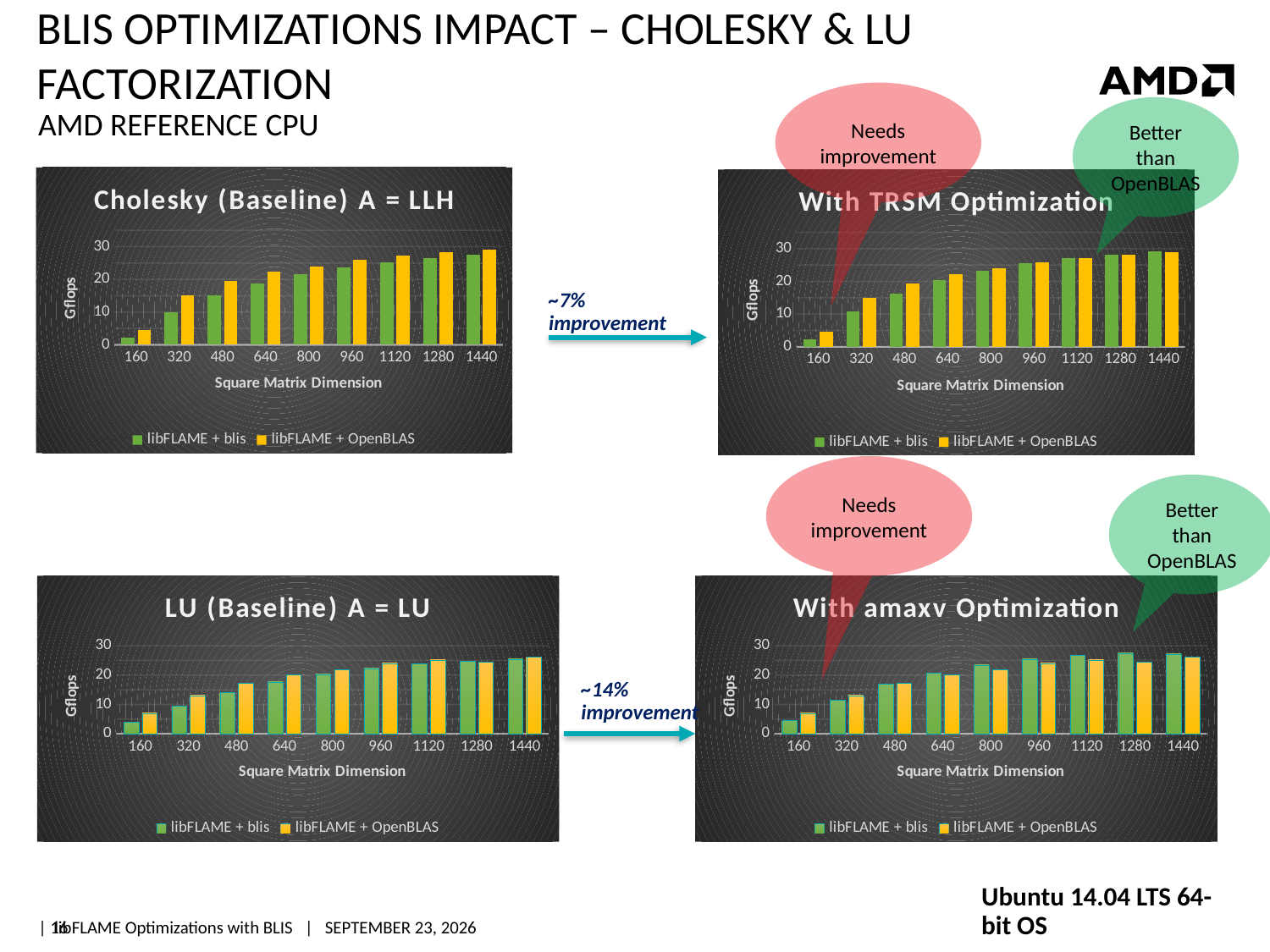
How many series does the legend of the "With TRSM Optimization" chart list? 2 What is the title of the bottom-left chart? LU (Baseline) A = LU In the "Cholesky (Baseline) A = LLH" chart, which series has the larger value at 320: libFLAME + blis or libFLAME + OpenBLAS? libFLAME + OpenBLAS What is the y-axis label on the "With amaxv Optimization" chart? Gflops In the "LU (Baseline) A = LU" chart, do the libFLAME + blis values rise or fall as the square matrix dimension increases? rise In the "Cholesky (Baseline) A = LLH" chart, is the libFLAME + blis value at 160 greater or less than 10? less In the "With amaxv Optimization" chart, is the libFLAME + blis value at 480 greater or less than 10? greater In the "With TRSM Optimization" chart, which square matrix dimension has the lowest libFLAME + blis value? 160 In the "With amaxv Optimization" chart, which series has the larger value at 960: libFLAME + blis or libFLAME + OpenBLAS? libFLAME + blis How many square matrix dimension categories are shown on the x axis of the "LU (Baseline) A = LU" chart? 9 In the "Cholesky (Baseline) A = LLH" chart, is the libFLAME + OpenBLAS value at 1440 greater or less than 20? greater What kind of chart is the "Cholesky (Baseline) A = LLH" chart? bar chart